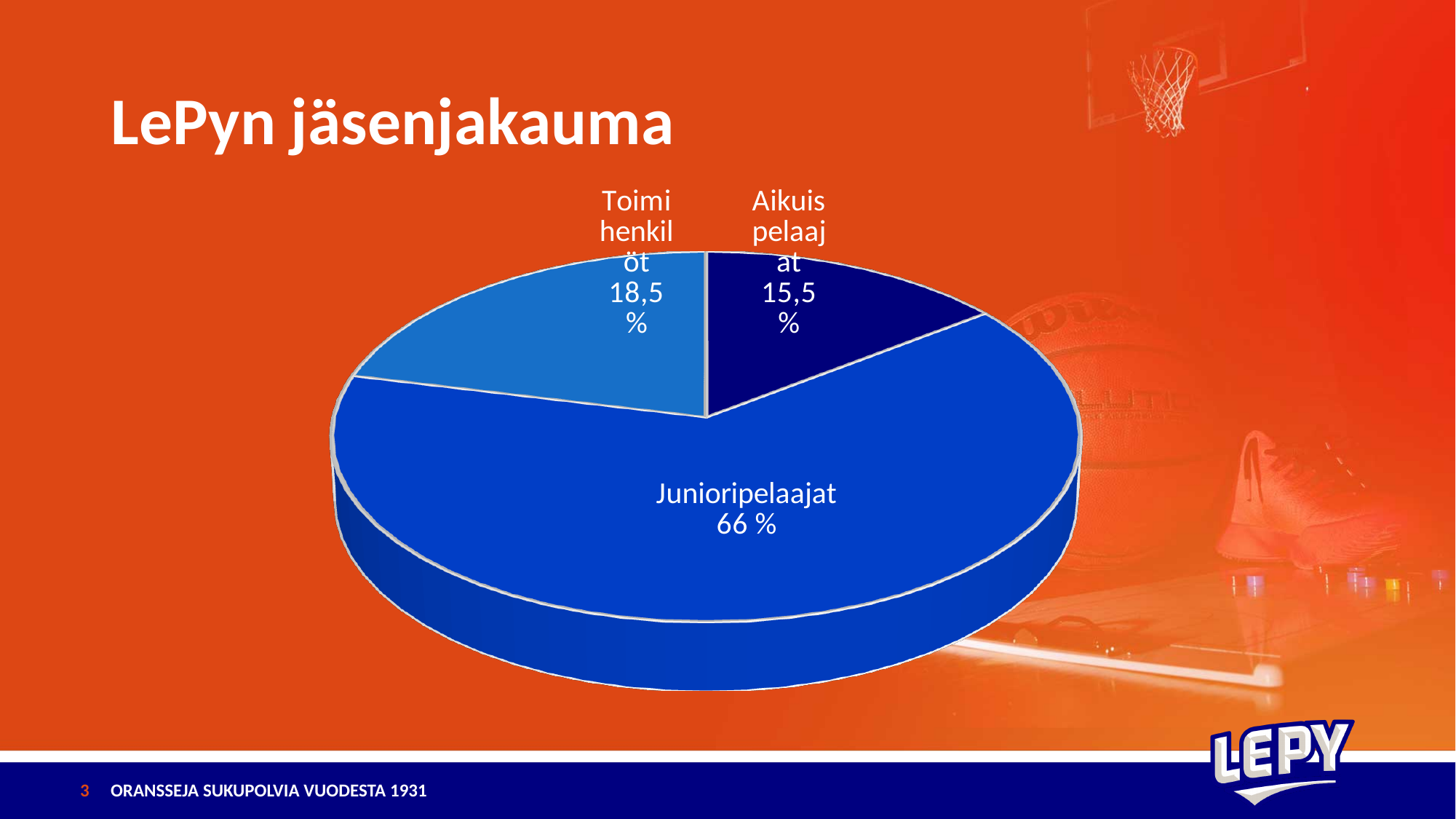
What is the difference between the shares of Junioripelaajat and Toimihenkilöt? 47,5 % What is the difference between the shares of Toimihenkilöt and Aikuispelaajat? 3 % Which category has the smallest slice of the pie? Aikuispelaajat What kind of chart is shown on the slide? Pie chart How many slices does the pie chart have? 3 Which is larger, the share of Toimihenkilöt or the share of Aikuispelaajat? Toimihenkilöt What is the title of the slide containing the chart? LePyn jäsenjakauma What colour is the Junioripelaajat slice? Blue Which category has the largest slice of the pie? Junioripelaajat What share of the pie does Junioripelaajat have? 66 % What share of the pie does Aikuispelaajat have? 15,5 % What share of the pie does Toimihenkilöt have? 18,5 %